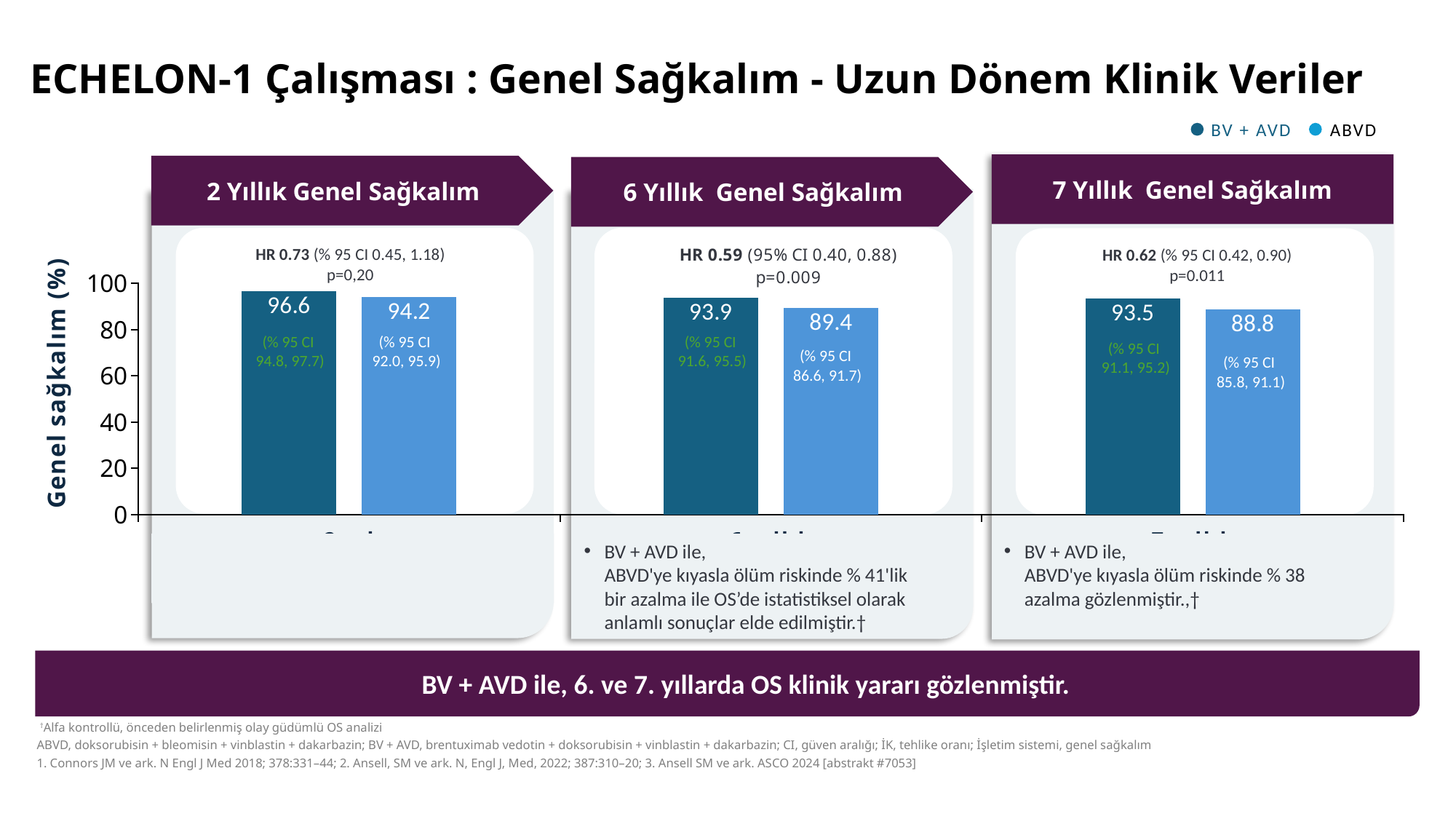
What is the 2-year overall survival value for BV + AVD? 96.6 What kind of chart is shown on the slide? Bar chart What is the 2-year overall survival value for ABVD? 94.2 How many series does the legend list? 2 Which series has the higher value at 6 years, BV + AVD or ABVD? BV + AVD What is the difference between the BV + AVD and ABVD values at 6 years? 4.5 What is the 6-year overall survival value for BV + AVD? 93.9 What is the difference between the BV + AVD and ABVD values at 7 years? 4.7 Do the BV + AVD values rise or fall from the 2-year to the 7-year time point? Fall What is the 7-year overall survival value for ABVD? 88.8 Which bar shows the lowest overall survival value on the chart? ABVD at 7 years (88.8) What is the 6-year overall survival value for ABVD? 89.4